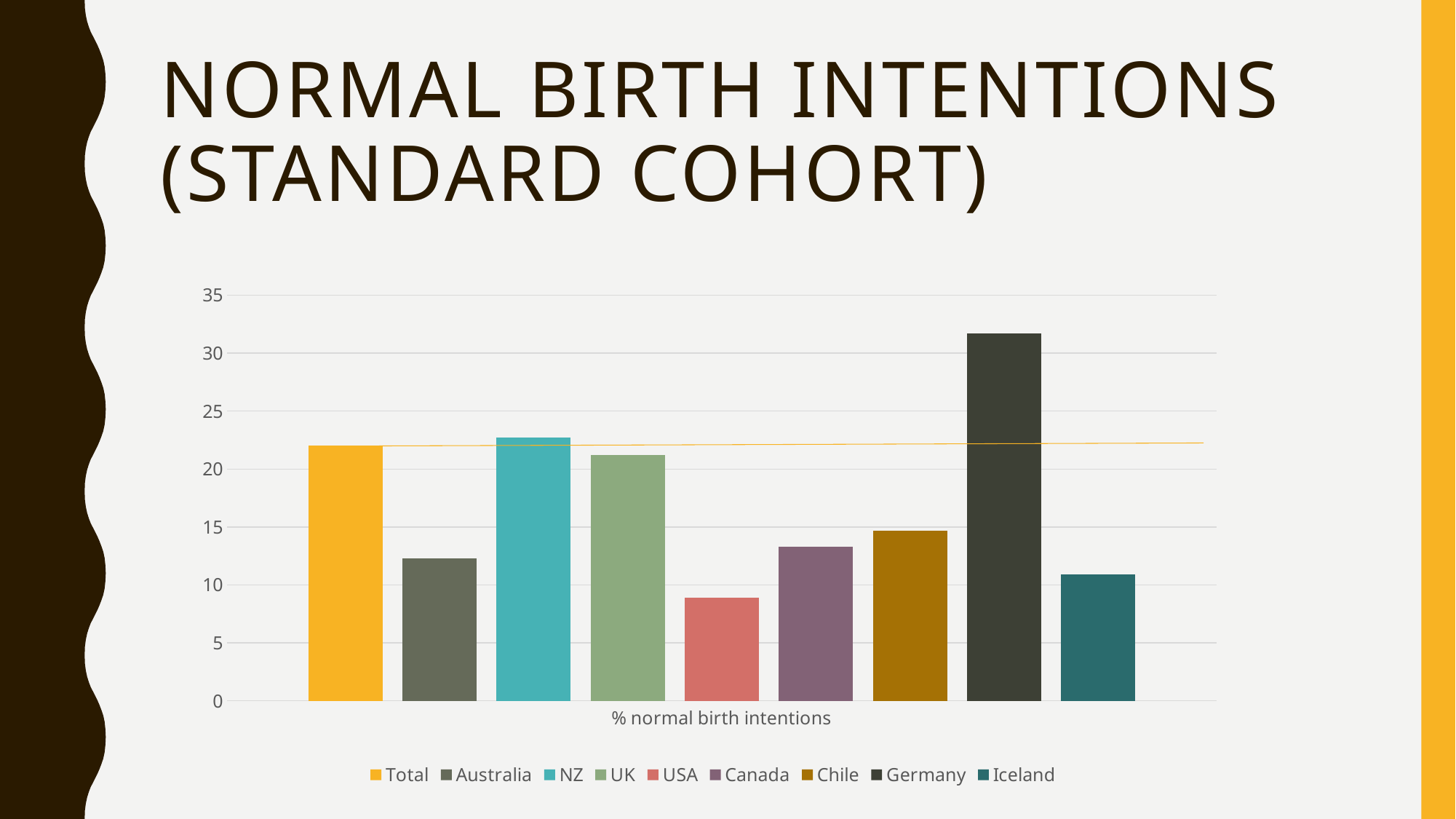
Is the value for Germany greater or less than 30? greater Which series has the lowest value? USA Is the value for Australia greater or less than 15? less How many series does the legend list? 9 Is the value for USA greater or less than 10? less What is the label shown on the x axis of the chart? % normal birth intentions What kind of chart is shown on the slide? bar chart Which series has the highest value? Germany Which is larger, the value for Germany or the value for Australia? Germany Which is larger, the value for NZ or the value for USA? NZ